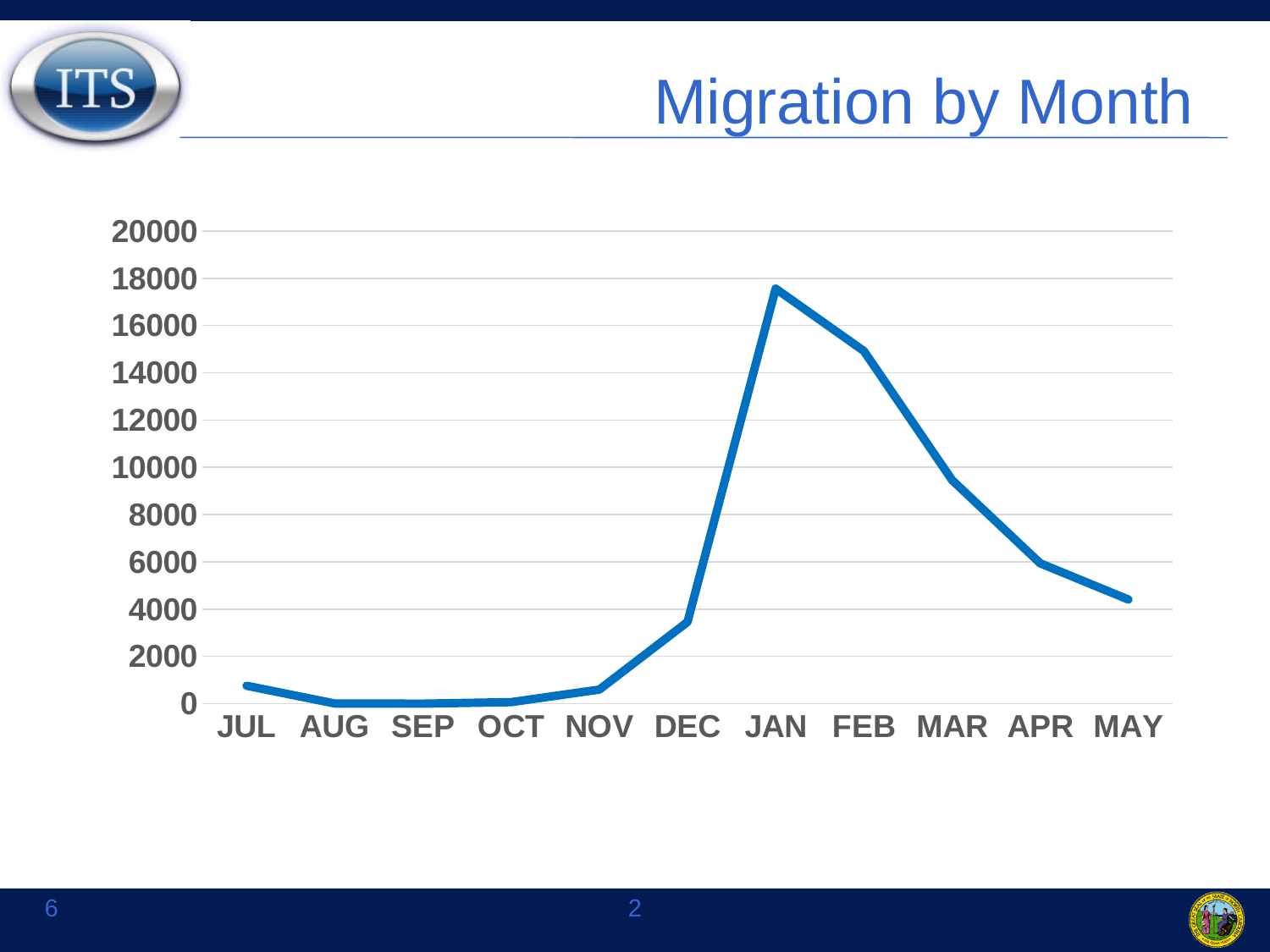
Which is larger, the value for FEB or the value for APR? FEB Is the value for MAY greater or less than 6000? less Do the values rise or fall from JAN to MAY? fall Is the value for JAN greater or less than 16000? greater How many months are plotted along the x axis? 11 Is the value for DEC greater or less than 4000? less Do the values rise or fall from OCT to JAN? rise What is the title of the chart? Migration by Month What kind of chart is shown on the slide? line chart Which month has the highest migration value? JAN